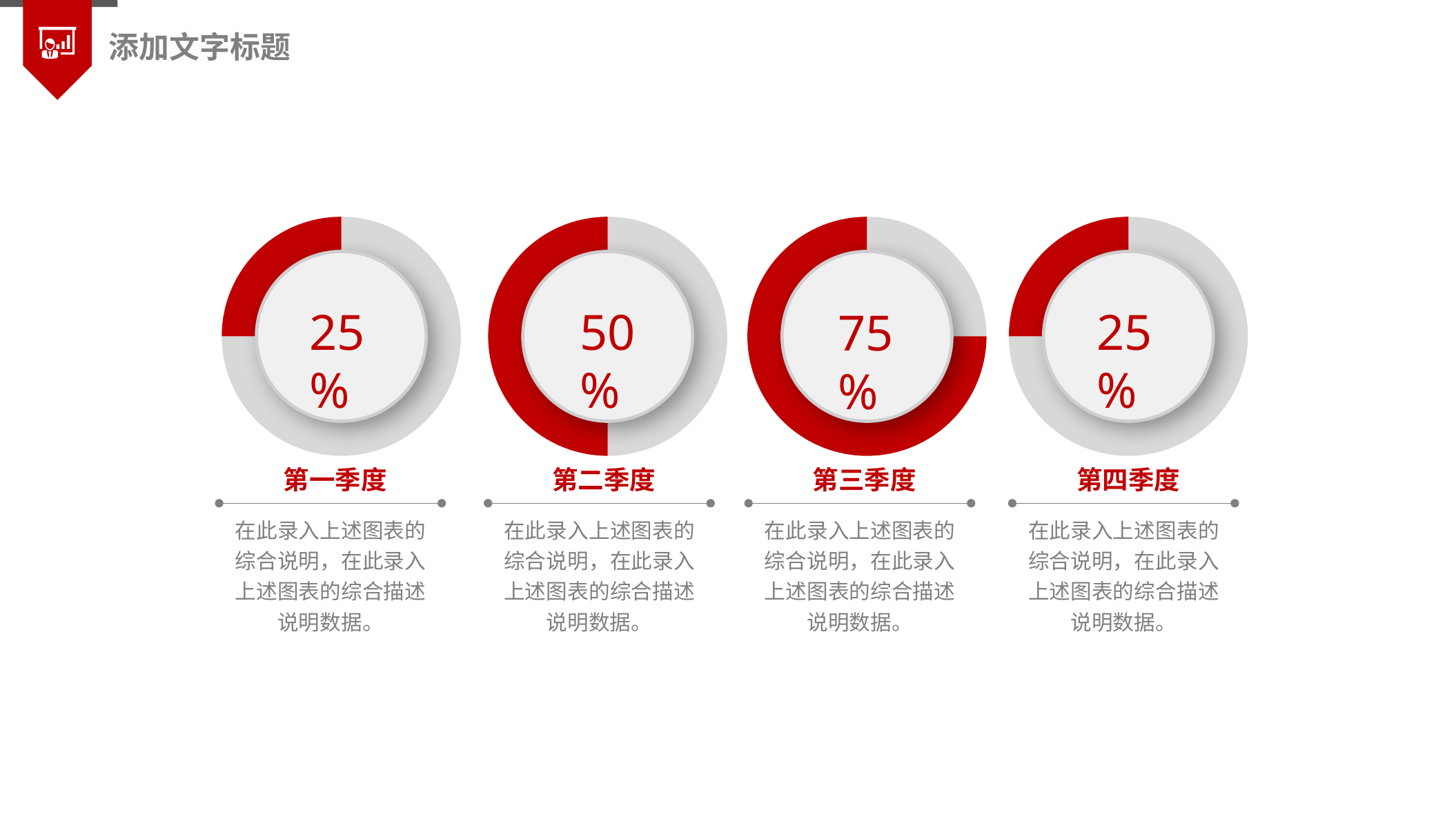
What value is shown in the 第四季度 chart? 25% What is the difference between the 第二季度 value and the 第四季度 value? 25% Which quarter's chart shows the highest percentage? 第三季度 How many ring charts are shown on the slide? 4 What colour is the filled portion of each ring chart? Red What value is shown in the 第二季度 chart? 50% Which is larger, the 第二季度 value or the 第四季度 value? 第二季度 What kind of chart is used for each quarter on the slide? Donut (ring) chart Which is larger, the 第三季度 value or the 第二季度 value? 第三季度 What is the difference between the 第三季度 value and the 第一季度 value? 50% What value is shown in the 第一季度 chart? 25% What value is shown in the 第三季度 chart? 75%